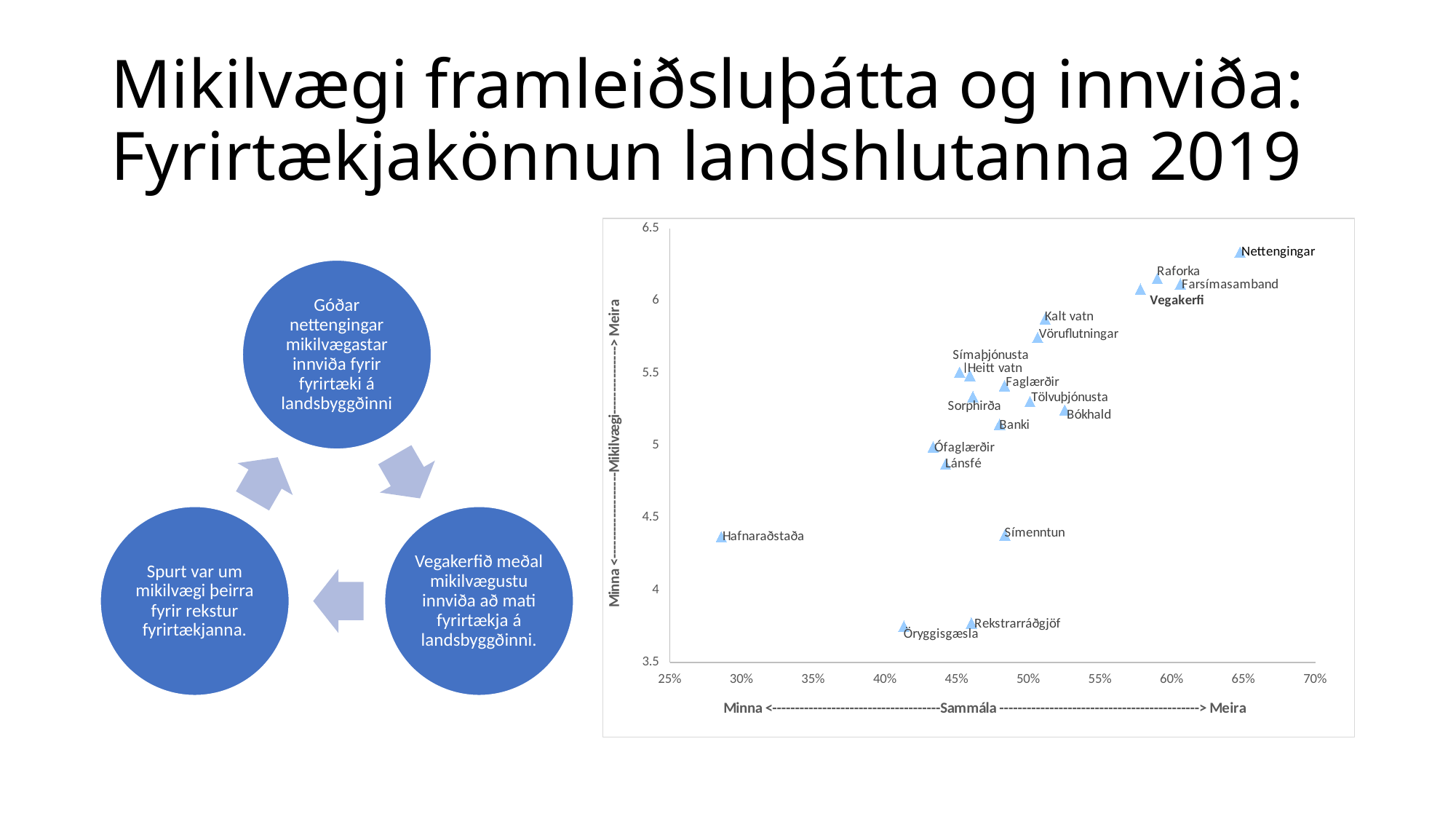
What kind of chart is shown on the slide? scatter chart Which has the higher vertical-axis value, Kalt vatn or Banki? Kalt vatn What is the lowest percentage shown on the horizontal axis? 25% How many labelled points are plotted on the chart? 19 Which point has the highest value on the vertical (Mikilvægi) axis? Nettengingar Is the vertical-axis value for Hafnaraðstaða greater or less than 4.5? less Is the vertical-axis value for Kalt vatn greater or less than 5.5? greater Is the horizontal-axis value for Hafnaraðstaða greater or less than 30%? less Which point is furthest to the left on the horizontal (Sammála) axis? Hafnaraðstaða Which point is furthest to the right on the horizontal (Sammála) axis? Nettengingar